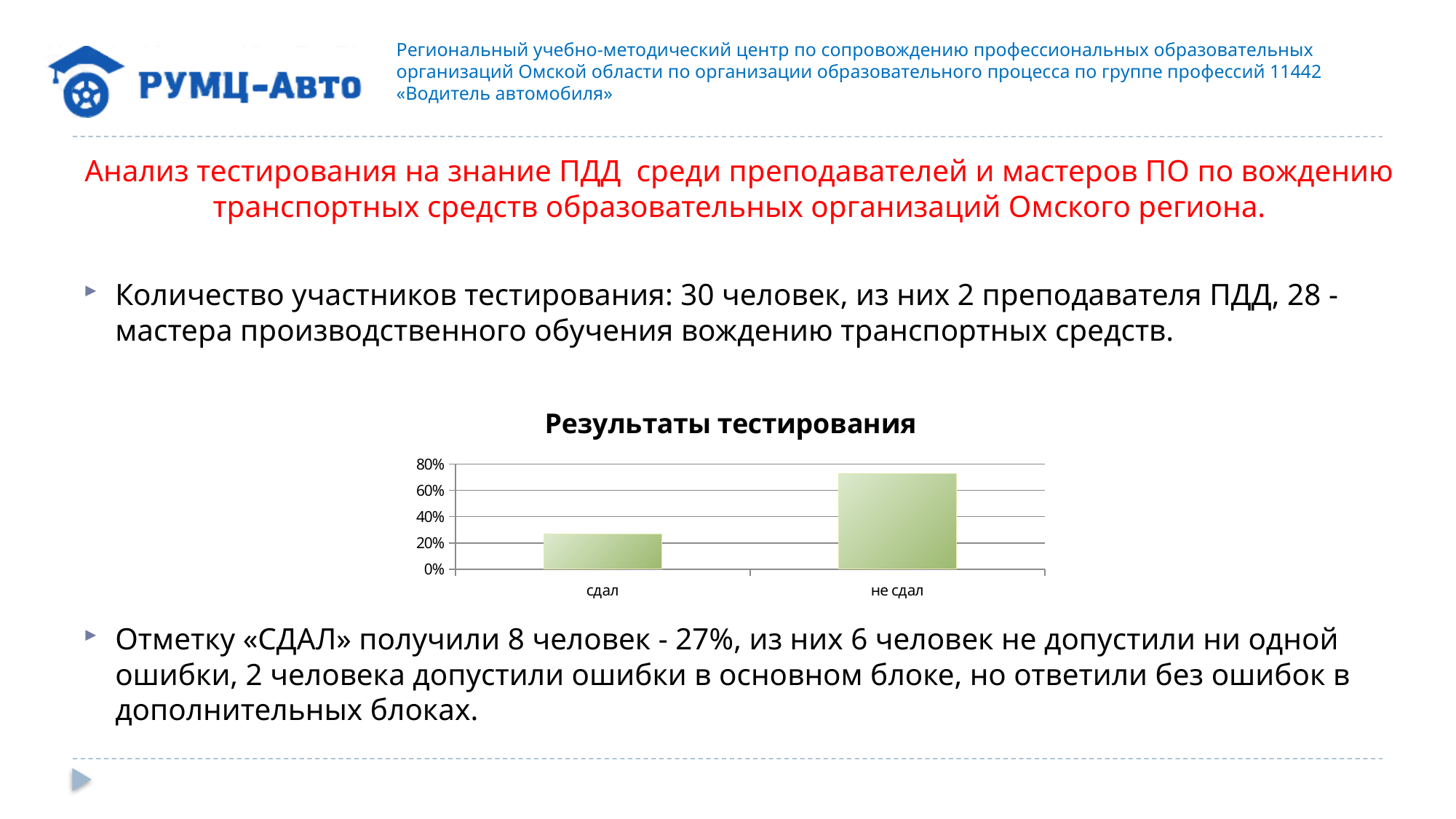
Which category has the highest bar in the "Результаты тестирования" chart? не сдал In the "Результаты тестирования" chart, which is larger: the value for "сдал" or the value for "не сдал"? не сдал What kind of chart is shown under the title "Результаты тестирования"? bar chart In the "Результаты тестирования" chart, is the value for "сдал" greater or less than 40%? less What is the highest tick label on the vertical axis of the "Результаты тестирования" chart? 80% In the "Результаты тестирования" chart, is the value for "не сдал" greater or less than 80%? less Do the bar values rise or fall from left to right in the "Результаты тестирования" chart? rise In the "Результаты тестирования" chart, is the value for "не сдал" greater or less than 60%? greater Which category has the lowest bar in the "Результаты тестирования" chart? сдал How many categories are shown on the x axis of the "Результаты тестирования" chart? 2 What is the title of the chart on the slide? Результаты тестирования